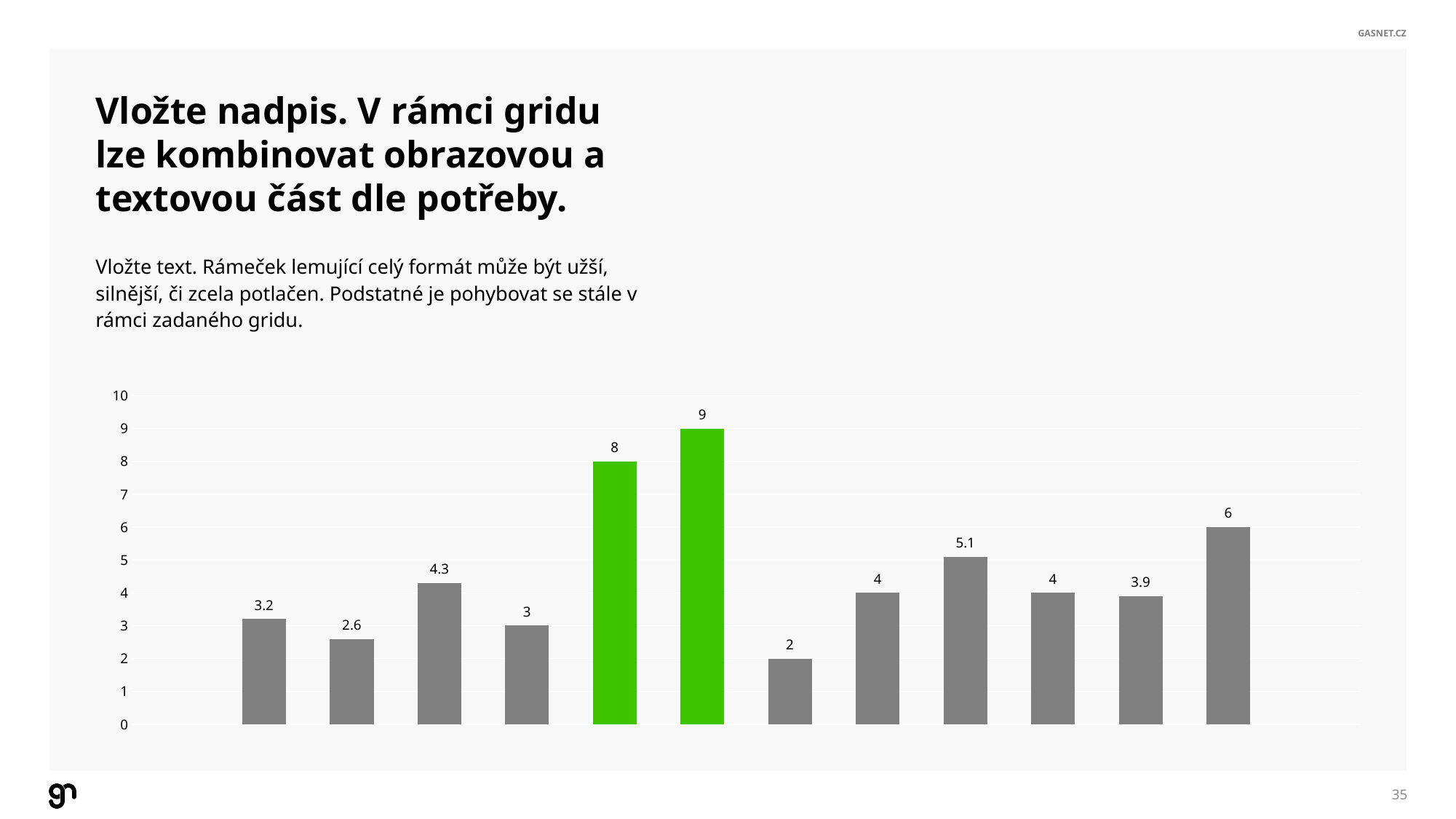
How many bars are coloured green? 2 What is the lowest value shown on the chart? 2 What kind of chart is shown on the slide? bar chart How many bars does the chart contain? 12 Is the value of the tallest green bar greater or less than 8? greater What is the value of the first bar from the left? 3.2 What is the highest value shown on the chart? 9 What is the difference between the highest bar and the lowest bar? 7 What is the value of the third bar from the left? 4.3 Which is larger, the second bar from the left (2.6) or the ninth bar from the left (5.1)? the ninth bar (5.1) What is the value of the last bar on the right? 6 What is the difference between the two green bars? 1